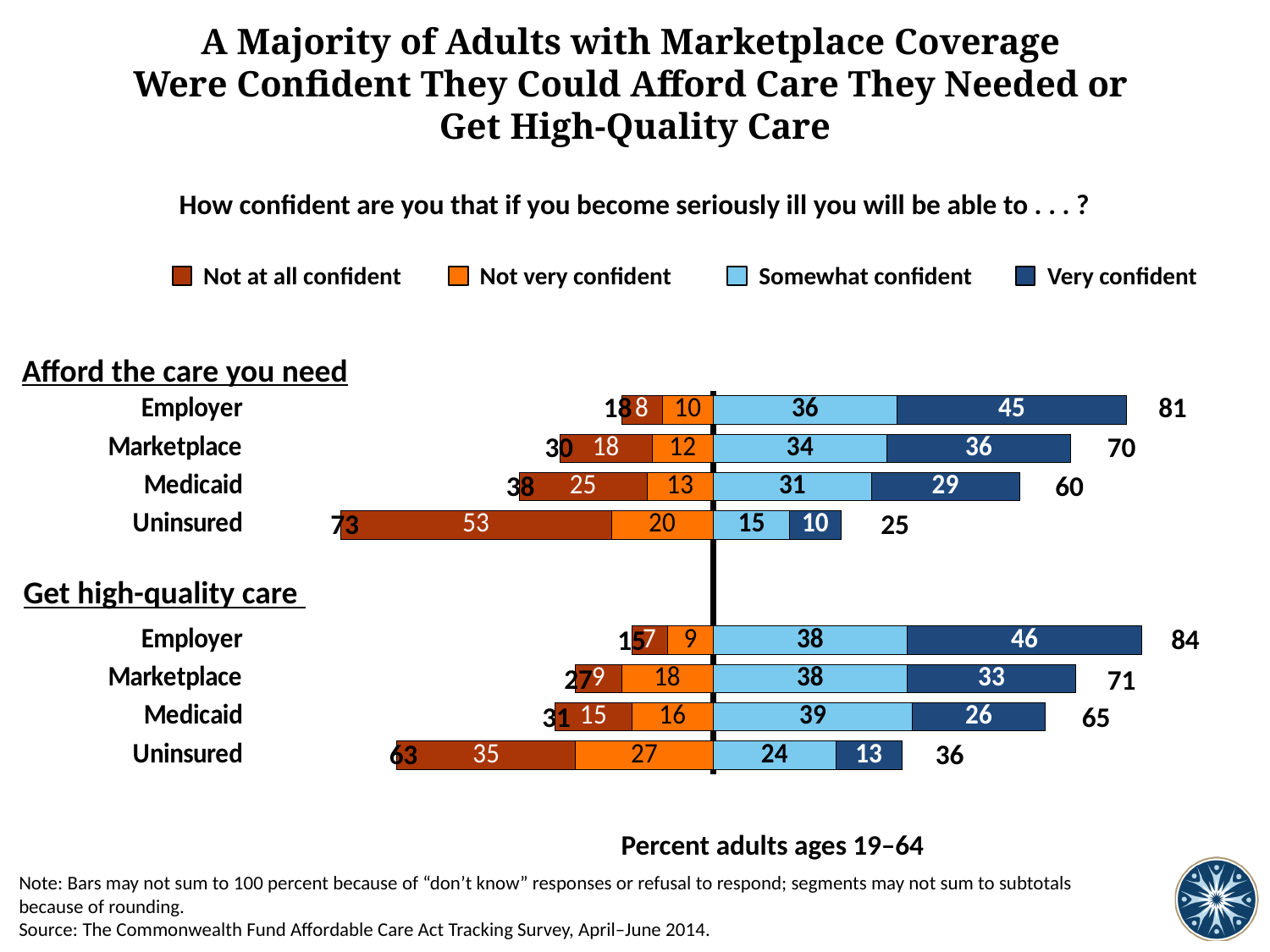
In the 'Afford the care you need' chart, what percent of Uninsured adults were not at all confident? 53 In the 'Afford the care you need' chart, what percent of adults with Employer coverage were very confident? 45 In the 'Get high-quality care' chart, which coverage group has the lowest very confident value? Uninsured How many series does the legend list? 4 In the 'Get high-quality care' chart, what is the difference between the not at all confident values for Uninsured and Medicaid? 20 In the 'Get high-quality care' chart, what is the combined somewhat/very confident subtotal shown for Medicaid? 65 In the 'Afford the care you need' chart, which coverage group has the highest very confident value? Employer In the 'Afford the care you need' chart, what is the difference between the very confident values for Employer and Marketplace? 9 What kind of chart is used on this slide? Stacked bar chart In the 'Get high-quality care' chart, what percent of adults with Marketplace coverage were somewhat confident? 38 How many coverage groups are shown in the 'Get high-quality care' chart? 4 In the 'Afford the care you need' chart, which is larger: the somewhat confident value for Marketplace or for Medicaid? Marketplace